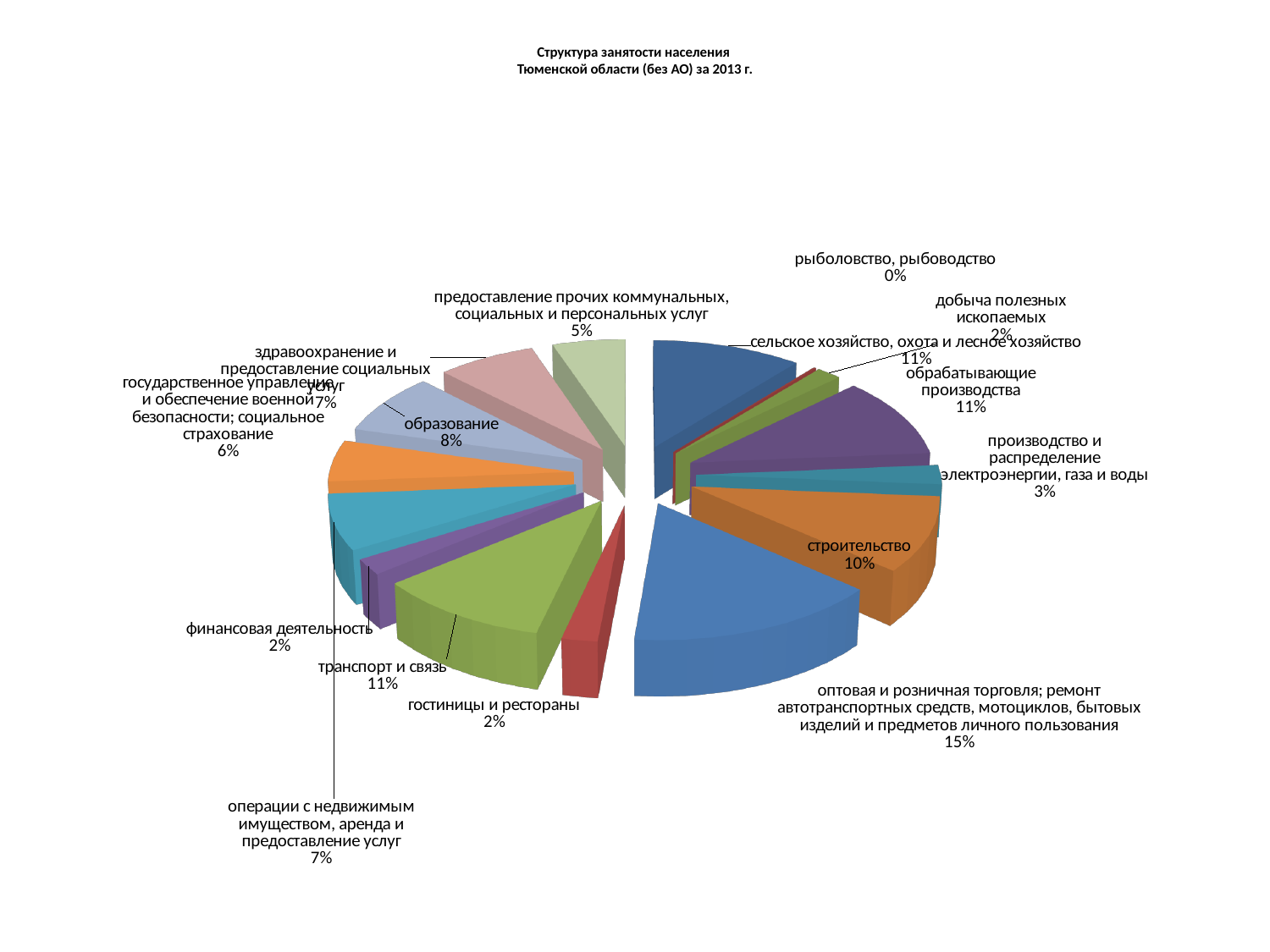
What is the title of the chart? Структура занятости населения Тюменской области (без АО) за 2013 г. What percentage is shown for "транспорт и связь"? 11% Which category has the largest share of the pie? оптовая и розничная торговля; ремонт автотранспортных средств, мотоциклов, бытовых изделий и предметов личного пользования What share is shown for "образование"? 8% Which has a larger share: "образование" or "здравоохранение и предоставление социальных услуг"? образование What share is shown for "предоставление прочих коммунальных, социальных и персональных услуг"? 5% What kind of chart is shown on the slide? pie chart What share is shown for "производство и распределение электроэнергии, газа и воды"? 3% How many categories are shown in the pie chart? 15 What share of employment does "строительство" have? 10% What is the difference in percentage points between "оптовая и розничная торговля" and "строительство"? 5 Which category has the smallest share of the pie? рыболовство, рыбоводство